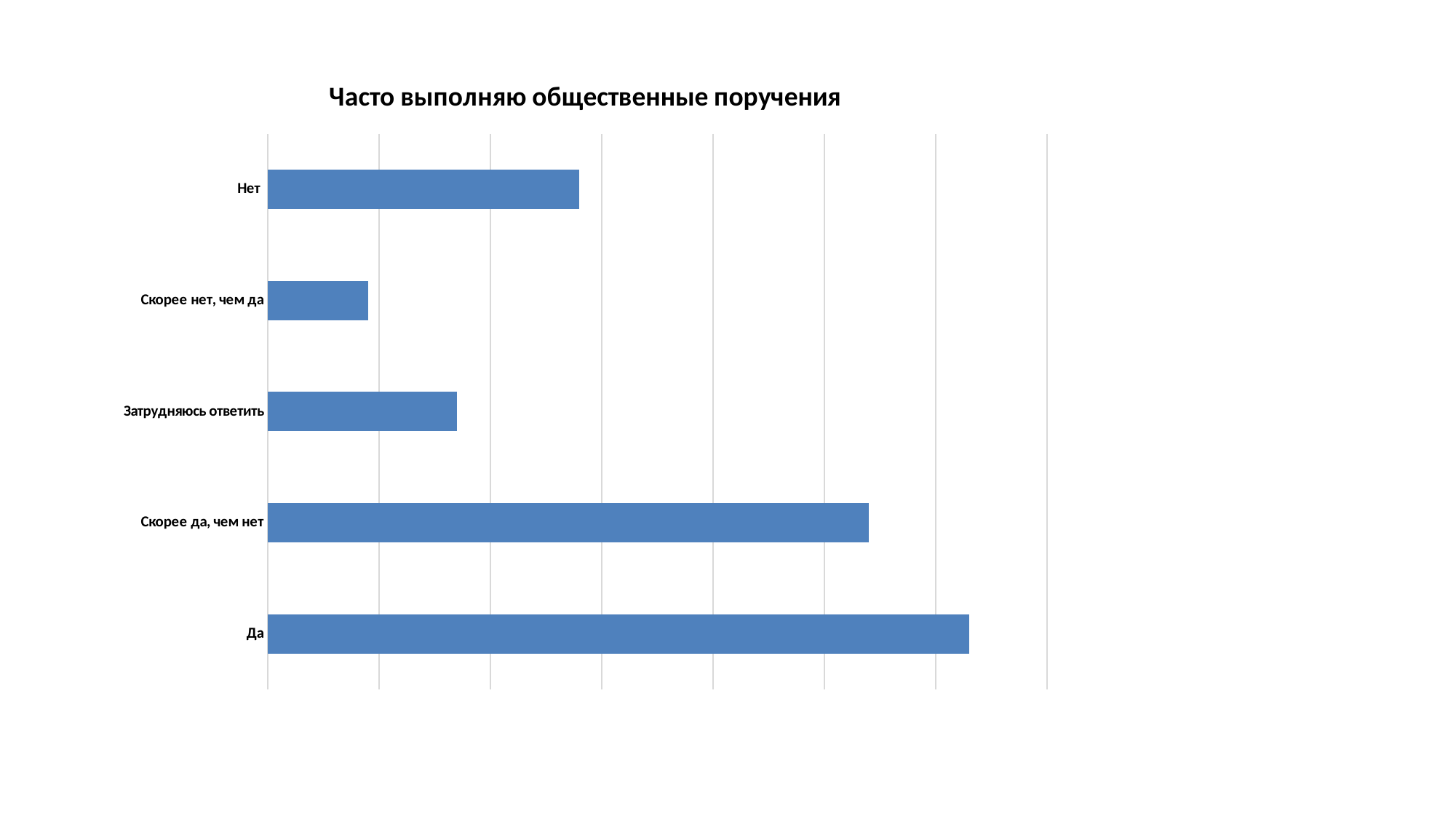
Are the bars in the chart horizontal or vertical? horizontal Which is larger, the value for Нет or the value for Затрудняюсь ответить? Нет What kind of chart is shown on the slide? bar chart Which category has the lowest value? Скорее нет, чем да What colour are the bars in the chart? blue What is the title of the chart? Часто выполняю общественные поручения Which category has the highest value? Да Which is larger, the value for Нет or the value for Скорее нет, чем да? Нет Which category has the second-highest value? Скорее да, чем нет Which is larger, the value for Да or the value for Скорее да, чем нет? Да How many categories are shown in the chart? 5